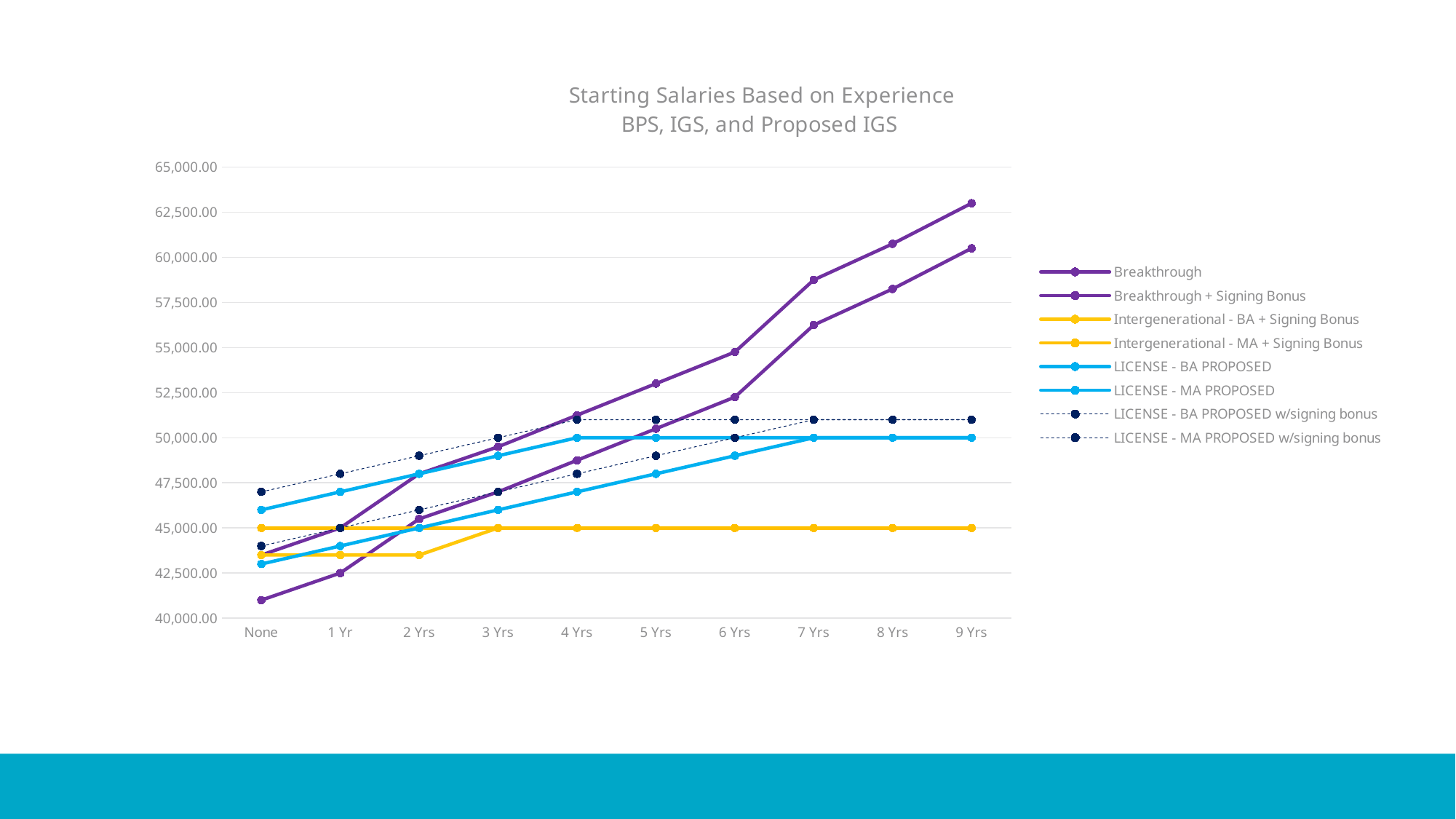
Which series are drawn with dashed lines in the legend? LICENSE - BA PROPOSED w/signing bonus and LICENSE - MA PROPOSED w/signing bonus How many series does the legend list? 8 At 9 Yrs, which is larger: the Intergenerational lines or the LICENSE PROPOSED lines? LICENSE PROPOSED lines What value do both LICENSE PROPOSED (solid blue) lines reach at 9 Yrs? 50,000.00 Is the lowest plotted value at None greater or less than 42,500.00? less Do the Intergenerational lines rise or fall between 3 Yrs and 9 Yrs? neither, they stay flat What is the title of the chart? Starting Salaries Based on Experience BPS, IGS, and Proposed IGS How many experience categories are shown on the x axis? 10 Do the Breakthrough lines rise or fall as years of experience increase? rise Is the highest plotted value at 9 Yrs greater or less than 62,500.00? greater What value do both Intergenerational lines show at 9 Yrs? 45,000.00 What type of chart is shown on the slide? Line chart